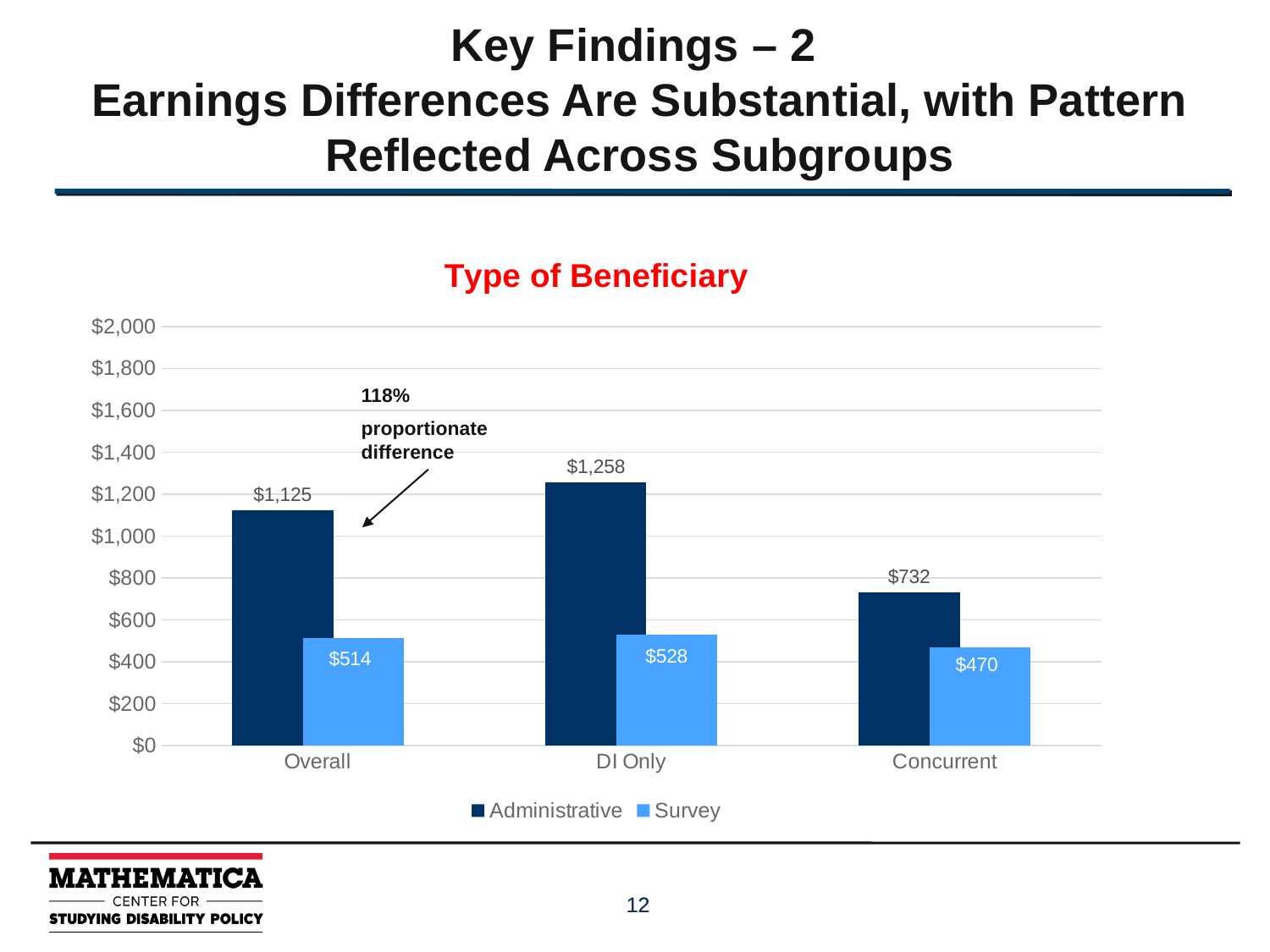
Which category has the highest Administrative value? DI Only What kind of chart is shown on the slide? Bar chart What is the Survey value for DI Only? $528 Which category has the lowest Survey value? Concurrent Which is larger, the Administrative value for Concurrent or the Survey value for DI Only? Administrative value for Concurrent What is the Administrative value for Overall? $1,125 What is the difference between the Administrative and Survey values for Overall? $611 What is the Survey value for Concurrent? $470 How many series does the legend list? 2 How many categories are shown on the x axis? 3 What is the difference between the Administrative values for DI Only and Concurrent? $526 What is the Administrative value for DI Only? $1,258